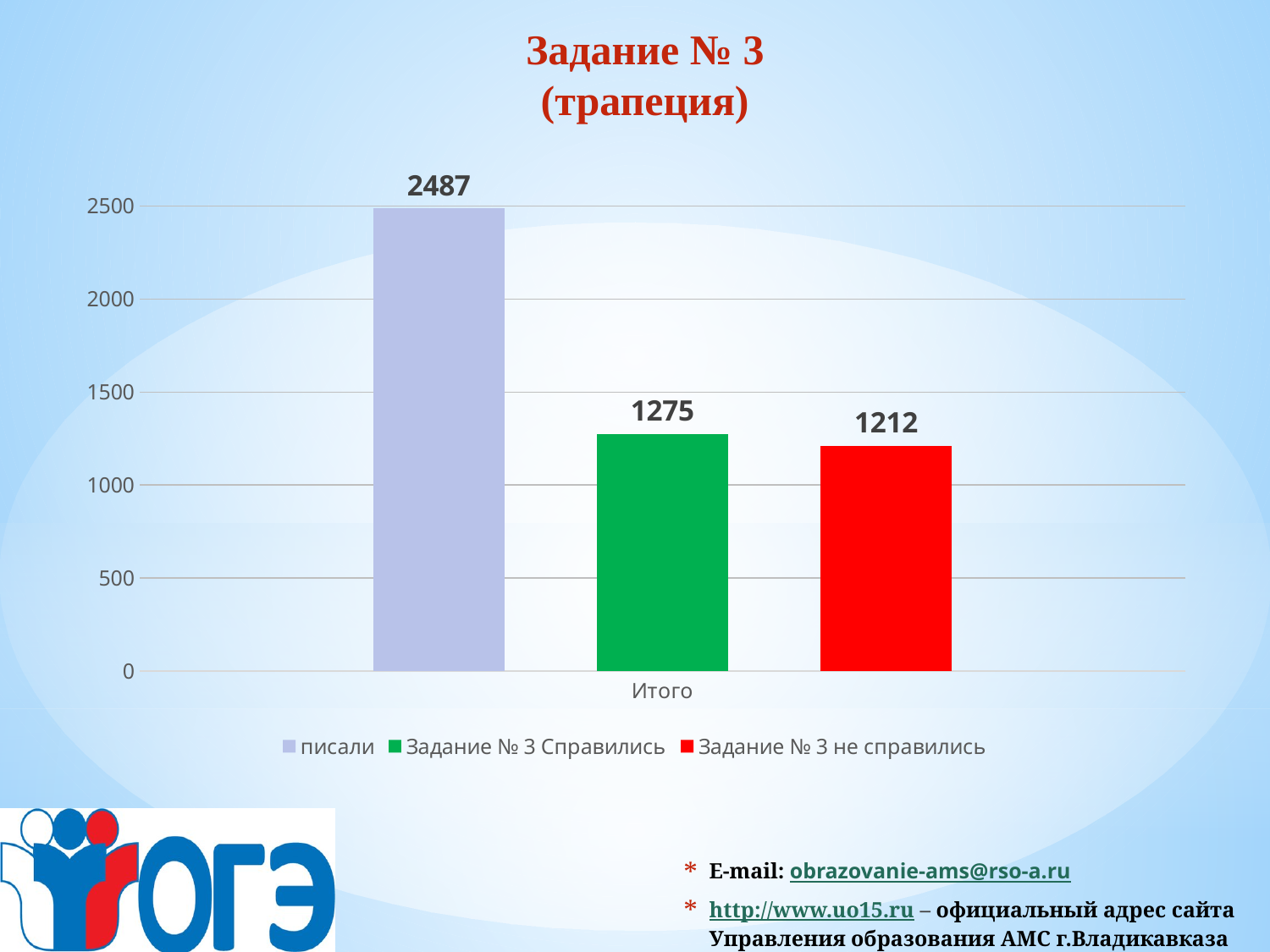
Which series has the lowest value? Задание № 3 не справились How many series does the legend list? 3 What is the value of the 'Задание № 3 Справились' bar? 1275 What is the category label on the x axis? Итого What is the difference between 'писали' and 'Задание № 3 Справились'? 1212 What is the value of the 'писали' bar? 2487 Which series has the highest value? писали What is the difference between 'Задание № 3 Справились' and 'Задание № 3 не справились'? 63 Is the value for 'писали' greater or less than 2000? greater What is the value of the 'Задание № 3 не справились' bar? 1212 Which is larger: 'Задание № 3 Справились' or 'Задание № 3 не справились'? Задание № 3 Справились What kind of chart is shown on the slide? bar chart